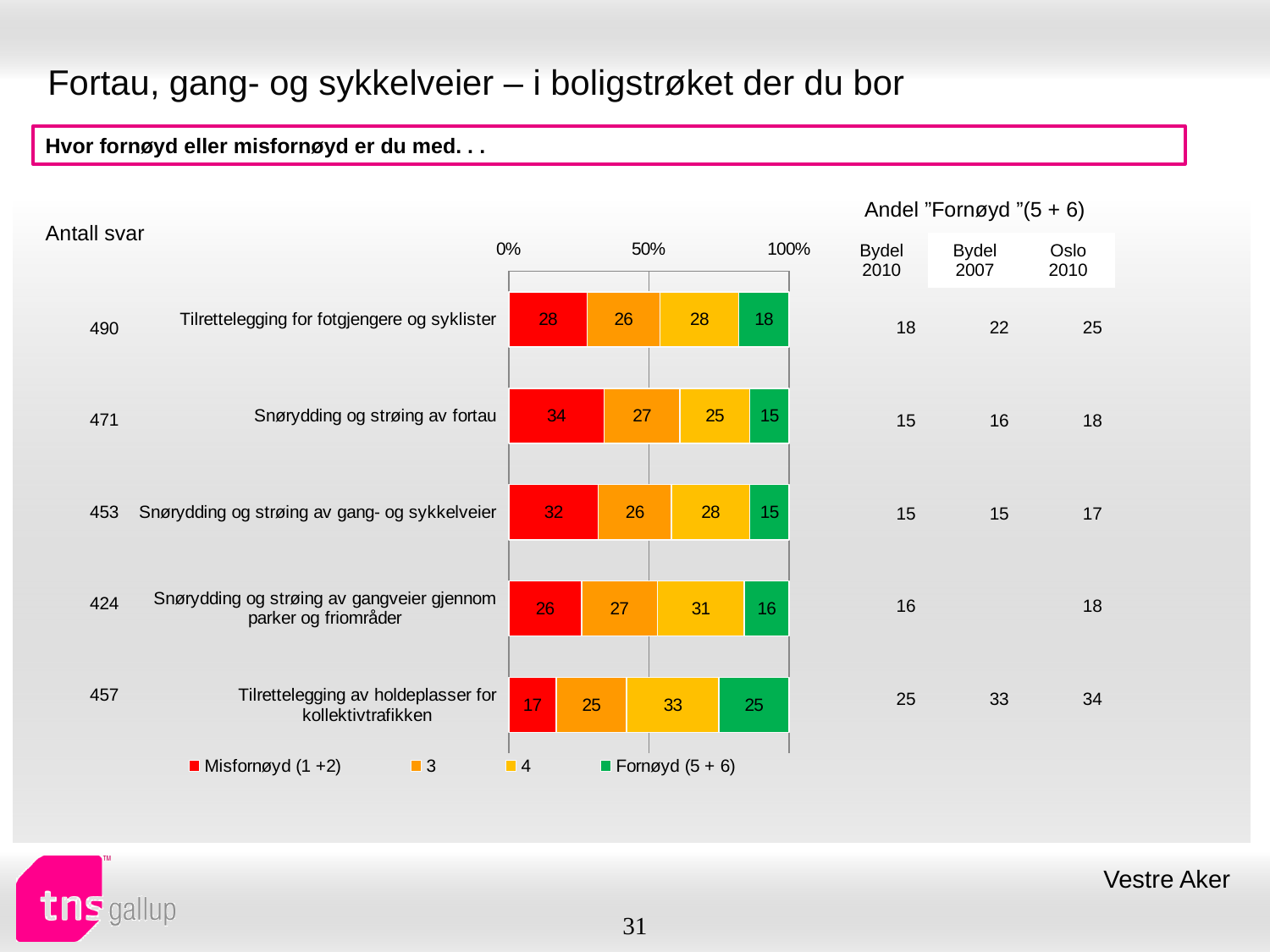
What is the value of "Misfornøyd (1 +2)" for "Snørydding og strøing av fortau"? 34 How many categories are shown in the chart? 5 What is the value of series "4" for "Snørydding og strøing av gangveier gjennom parker og friområder"? 31 What is the difference between the "Fornøyd (5 + 6)" values for "Tilrettelegging av holdeplasser for kollektivtrafikken" and "Snørydding og strøing av fortau"? 10 What kind of chart is shown on the slide? Stacked bar chart Which category has the highest "Misfornøyd (1 +2)" value? Snørydding og strøing av fortau Which is larger: the "Misfornøyd (1 +2)" value for "Snørydding og strøing av gang- og sykkelveier" or for "Tilrettelegging for fotgjengere og syklister"? Snørydding og strøing av gang- og sykkelveier What is the value of "Fornøyd (5 + 6)" for "Tilrettelegging av holdeplasser for kollektivtrafikken"? 25 How many series does the legend list? 4 What colour represents the "Fornøyd (5 + 6)" series in the chart? Green What is the total of the stacked bar for "Tilrettelegging for fotgjengere og syklister"? 100 Which category has the lowest "Misfornøyd (1 +2)" value? Tilrettelegging av holdeplasser for kollektivtrafikken